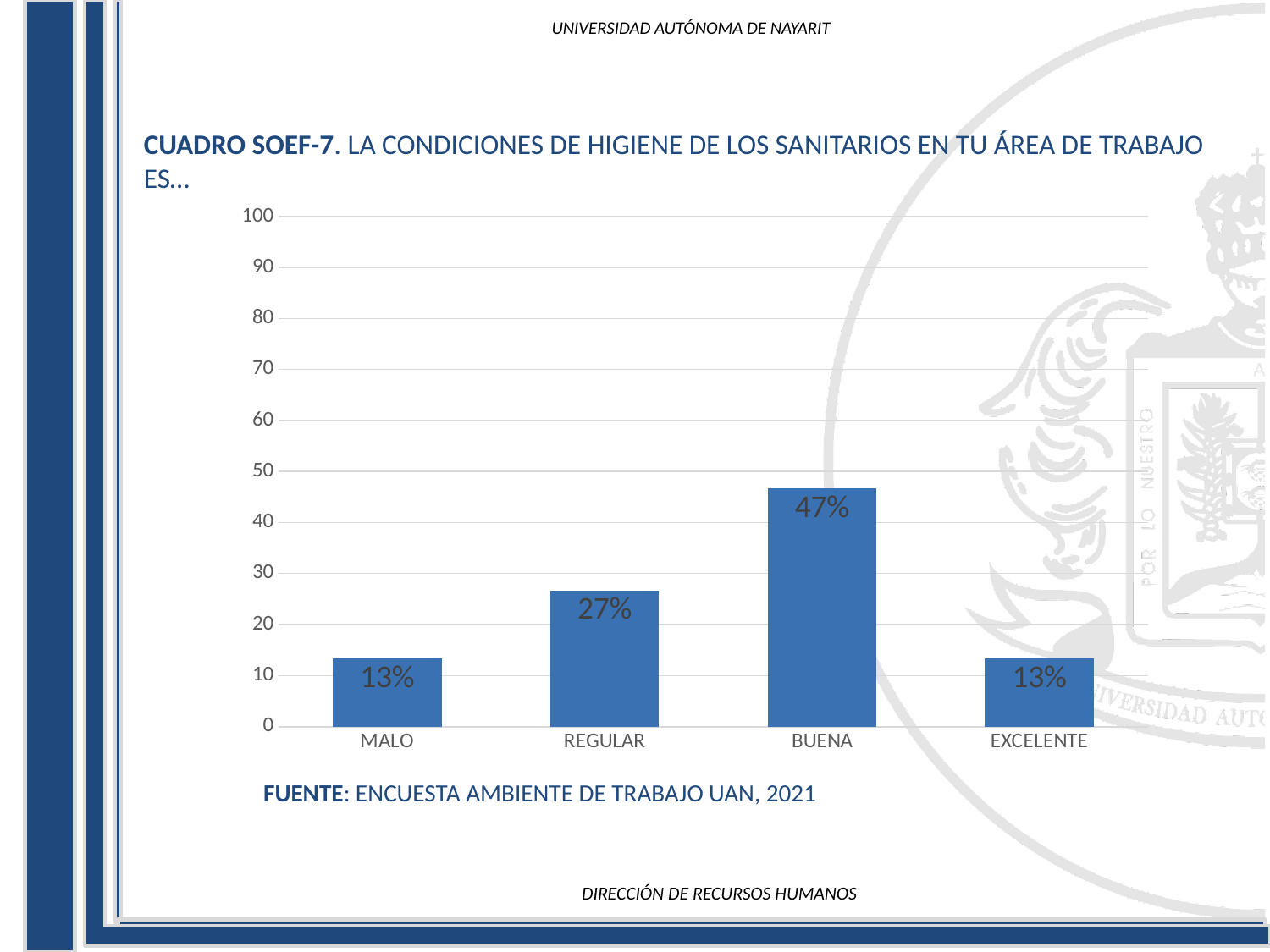
Which category has the highest value? BUENA Is the value for MALO greater or less than 20? less Is the value for BUENA greater or less than 40? greater What is the value for REGULAR? 27% Which is larger, the value for REGULAR or the value for EXCELENTE? REGULAR What is the value for MALO? 13% What is the value for BUENA? 47% What kind of chart is shown on the slide? bar chart How many categories are shown on the x axis? 4 What source is cited below the chart? ENCUESTA AMBIENTE DE TRABAJO UAN, 2021 What is the difference between the values for REGULAR and EXCELENTE? 14% What is the difference between the values for BUENA and REGULAR? 20%